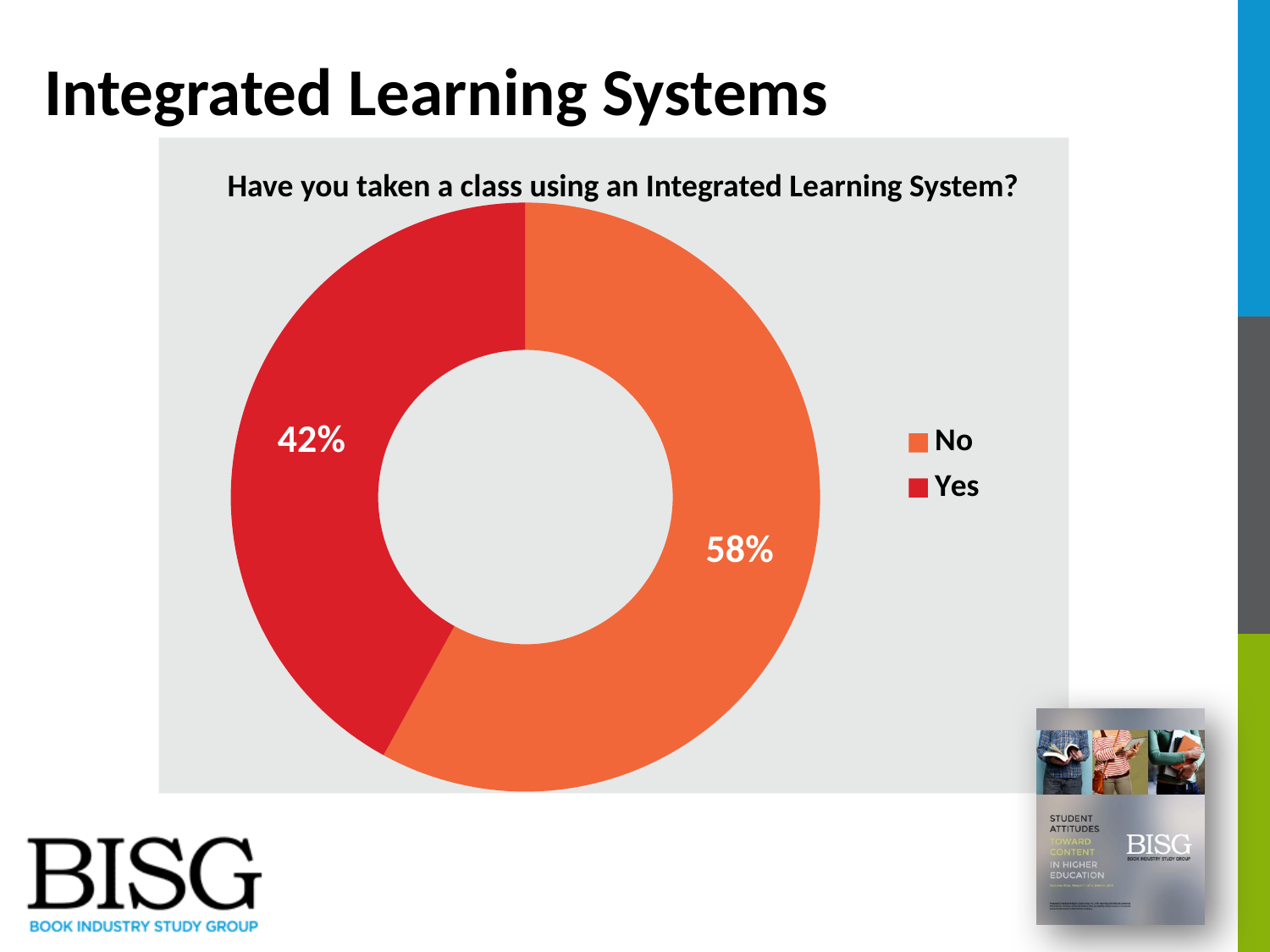
Which response has the smaller share of the chart? Yes What colour represents the "Yes" response in the chart? Red How many entries does the legend list? 2 Which response has the larger share of the chart, "No" or "Yes"? No Is the value for "No" greater or less than 50%? greater How many categories does the chart show? 2 What percentage of respondents answered "Yes" to having taken a class using an Integrated Learning System? 42% What is the title of the chart? Have you taken a class using an Integrated Learning System? Is the share for "Yes" larger or smaller than the share for "No"? smaller What kind of chart is shown on the slide? Doughnut (pie) chart What percentage of respondents answered "No" to having taken a class using an Integrated Learning System? 58% What is the difference in percentage points between the "No" and "Yes" responses? 16